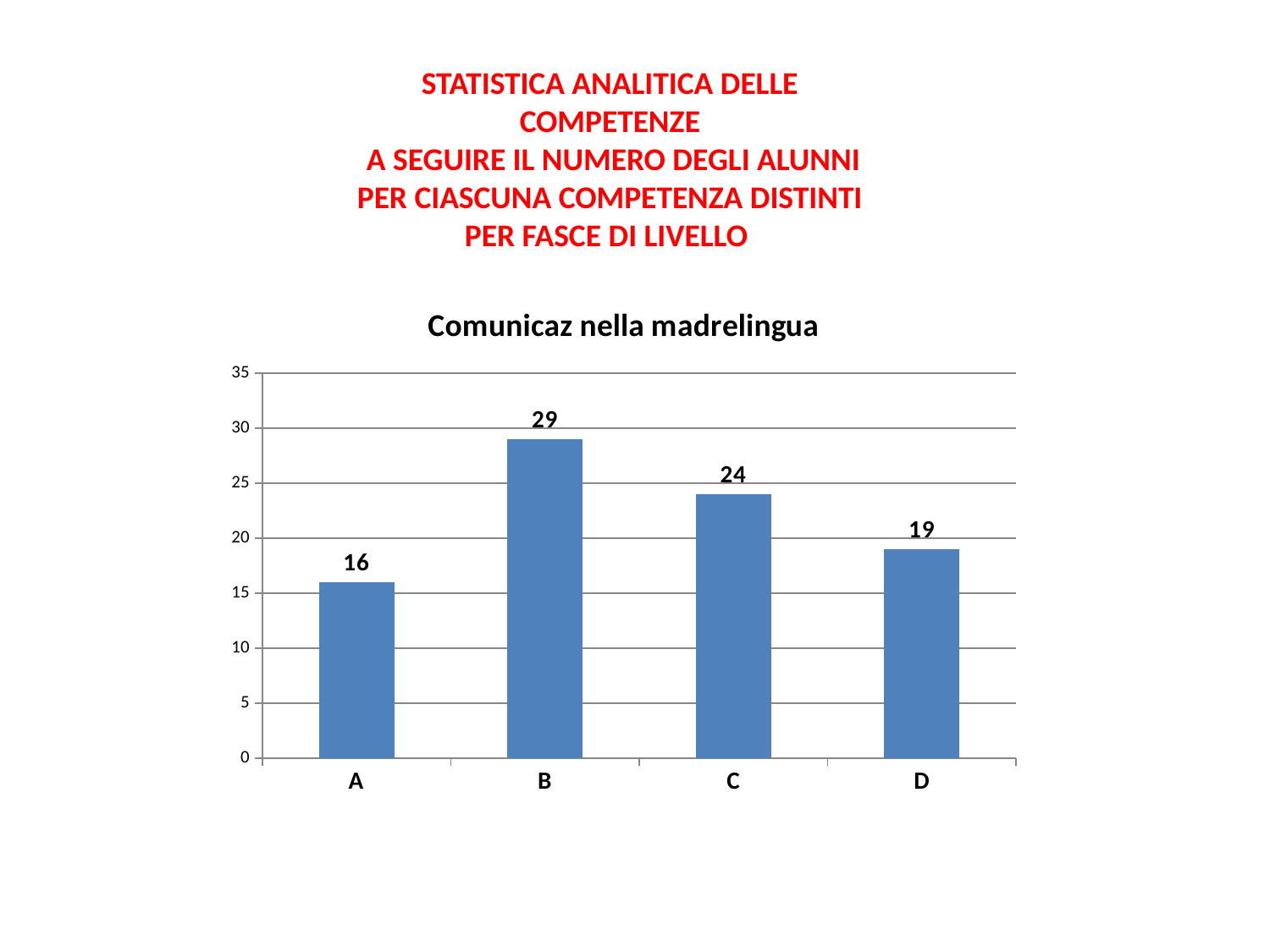
What kind of chart is shown? bar chart What is the value for category B? 29 Which category has the lowest value? A What is the value for category D? 19 Which is larger, the value for C or the value for D? C What is the value for category A? 16 What is the difference between the values for B and C? 5 What is the title of the chart? Comunicaz nella madrelingua Which category has the highest value? B Is the value for C greater or less than 20? greater What is the difference between the values for D and A? 3 How many categories are shown on the x axis? 4